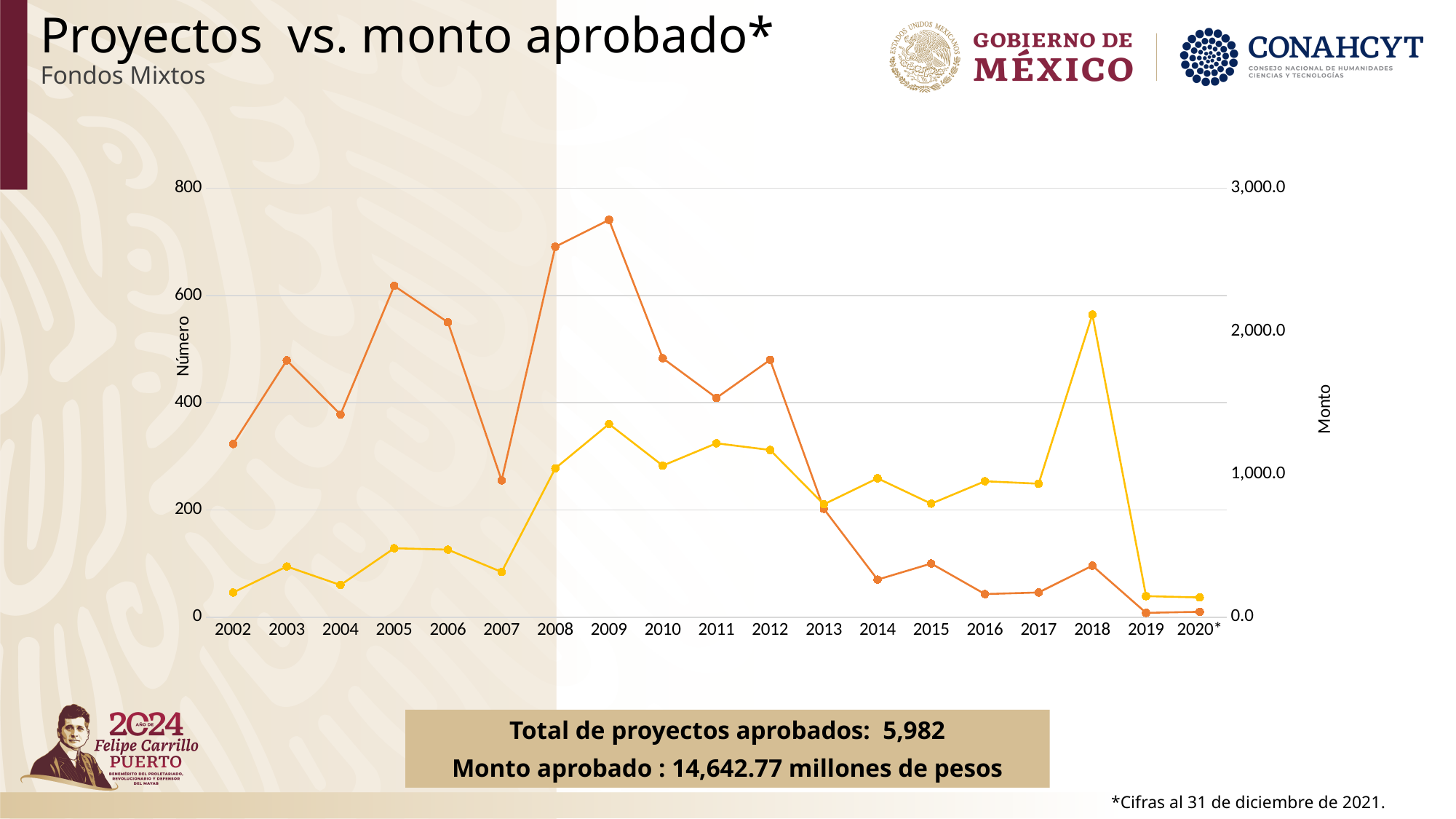
In which year does the orange line (Número) reach its highest value? 2009 In which year does the orange line (Número) reach its lowest value? 2019 Is the value of the orange line (Número) for 2009 greater or less than 600? greater On the orange line (Número), which year has the larger value, 2004 or 2005? 2005 What is the label of the left vertical axis of the chart? Número Is the value of the orange line (Número) for 2014 greater or less than 200? less Is the value of the orange line (Número) for 2007 greater or less than 400? less Does the orange line (Número) rise or fall between 2009 and 2014? fall How many years are plotted along the x axis of the chart? 19 In which year does the yellow line (Monto) reach its highest value? 2018 What kind of chart is shown on the slide? line chart